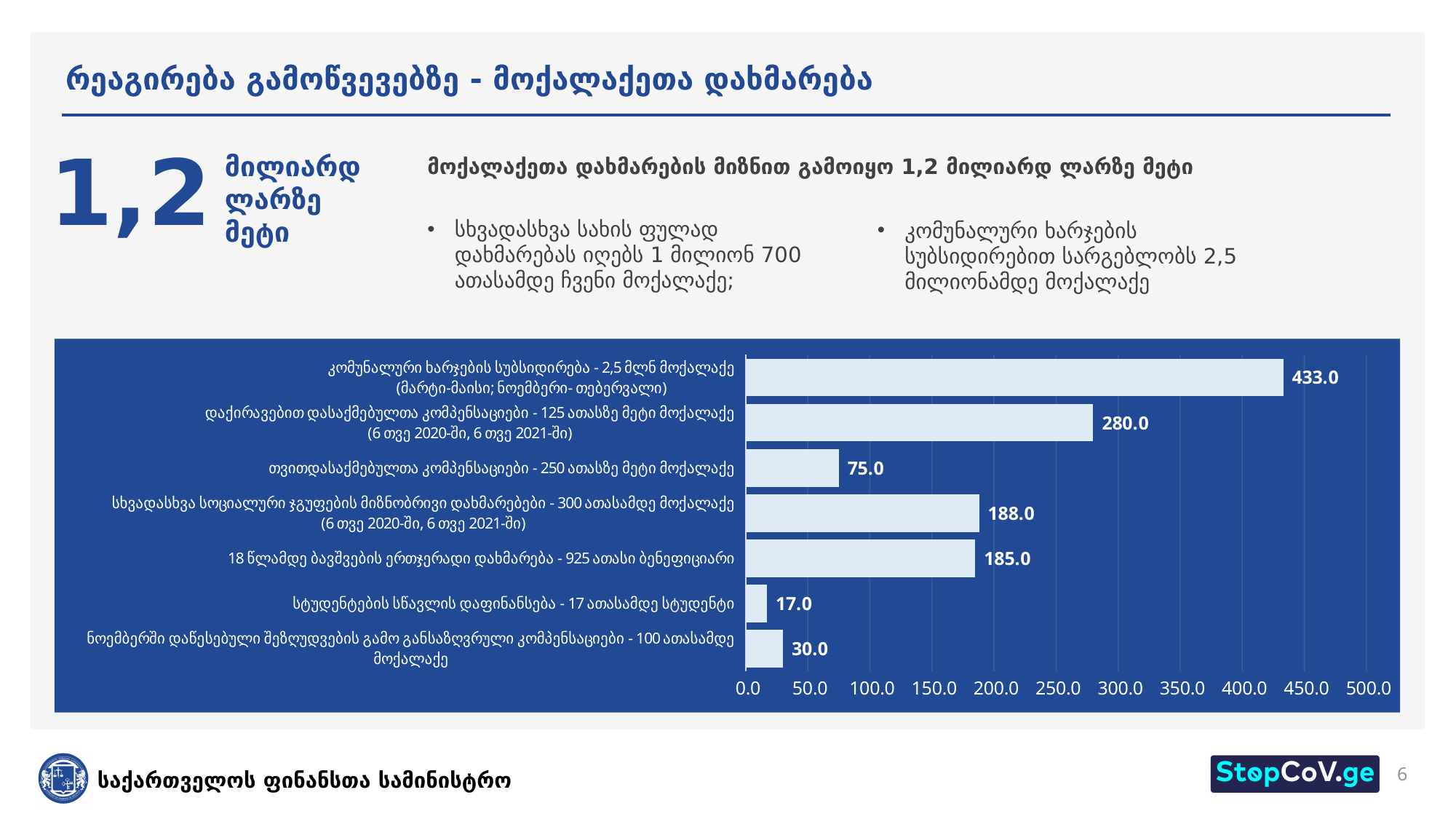
What is the value for "18 წლამდე ბავშვების ერთჯერადი დახმარება - 925 ათასი ბენეფიციარი"? 185.0 What is the value for "სტუდენტების სწავლის დაფინანსება - 17 ათასამდე სტუდენტი"? 17.0 What is the value for "კომუნალური ხარჯების სუბსიდირება - 2,5 მლნ მოქალაქე"? 433.0 What is the maximum value shown on the x axis of the chart? 500.0 Which category has the lowest value? სტუდენტების სწავლის დაფინანსება - 17 ათასამდე სტუდენტი How many categories (bars) does the chart show? 7 What is the value for "თვითდასაქმებულთა კომპენსაციები - 250 ათასზე მეტი მოქალაქე"? 75.0 Which is larger: the value for "სხვადასხვა სოციალური ჯგუფების მიზნობრივი დახმარებები" or for "თვითდასაქმებულთა კომპენსაციები"? სხვადასხვა სოციალური ჯგუფების მიზნობრივი დახმარებები Which category has the highest value? კომუნალური ხარჯების სუბსიდირება - 2,5 მლნ მოქალაქე What is the value for "დაქირავებით დასაქმებულთა კომპენსაციები - 125 ათასზე მეტი მოქალაქე"? 280.0 What type of chart is shown on the slide? bar chart What is the difference between the values for "კომუნალური ხარჯების სუბსიდირება" and "დაქირავებით დასაქმებულთა კომპენსაციები"? 153.0